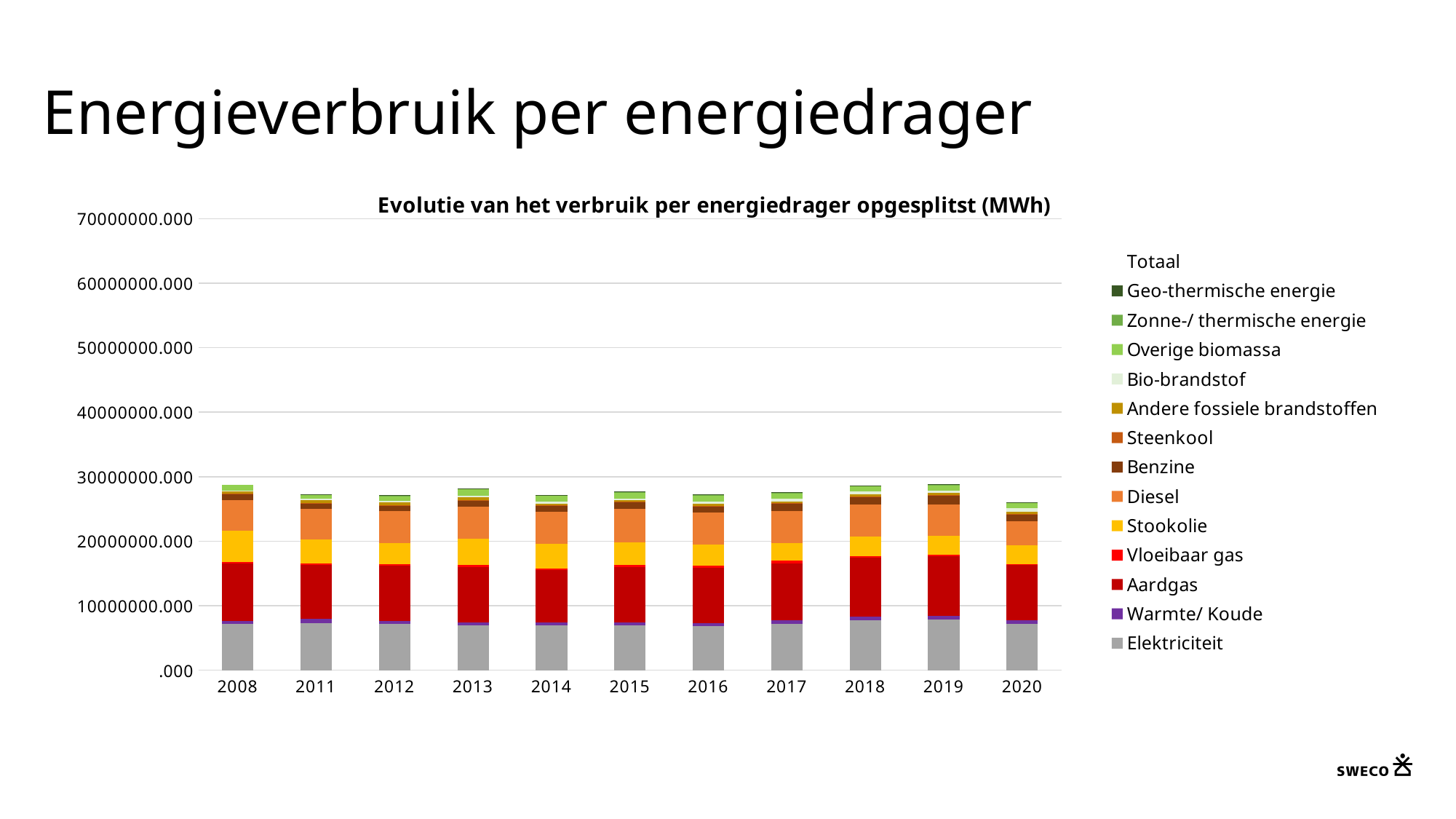
Which total bar is larger, 2019 or 2020? 2019 Is the total bar for 2008 greater or less than 40000000.000? less Which year has the lowest total bar? 2020 Is the Elektriciteit segment for 2008 greater or less than 10000000.000? less Is the total bar for 2020 greater or less than 20000000.000? greater Which total bar is larger, 2008 or 2020? 2008 How many years are shown on the x axis of the chart? 11 Which series forms the bottom segment of each stacked bar? Elektriciteit What is the title of the chart? Evolutie van het verbruik per energiedrager opgesplitst (MWh) What kind of chart is shown on the slide? Stacked bar chart Does the total bar rise or fall from 2019 to 2020? fall